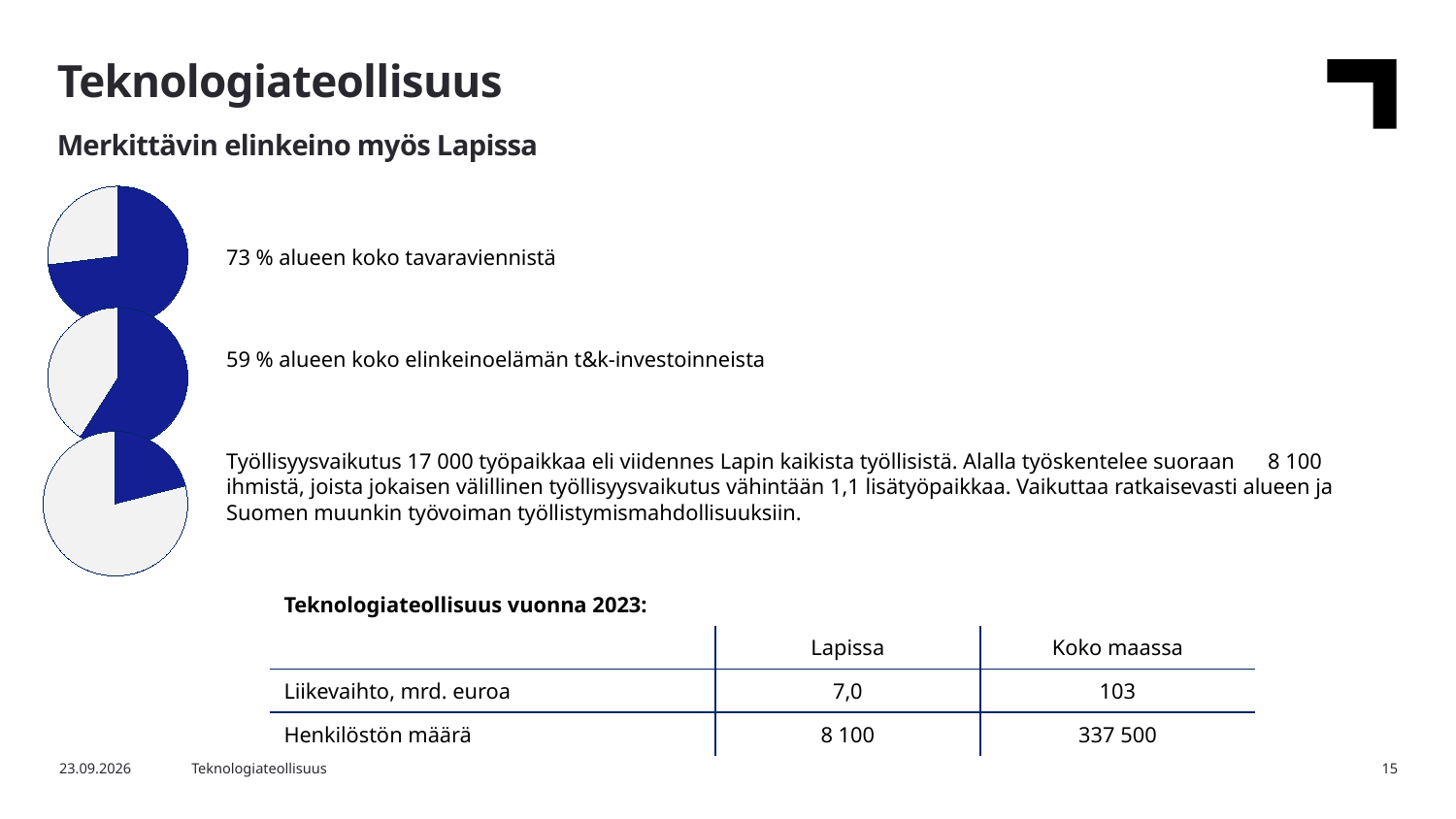
In the top pie chart, which slice is larger, the blue one or the grey one? The blue one What kind of charts are shown on the left side of the slide? Pie charts What does the blue slice of the top pie chart represent, according to the text next to it? 73 % alueen koko tavaraviennistä In the bottom pie chart, which slice is larger, the blue one or the grey one? The grey one What colour is the highlighted slice in the pie charts? Dark blue In the middle pie chart, what share does the blue slice represent? 59 % Which of the three pie charts has the largest blue slice? The top pie chart (73 %) Which of the three pie charts has the smallest blue slice? The bottom pie chart How many slices does each pie chart have? 2 Which pie chart has the larger blue slice, the top one or the middle one? The top one In the top pie chart, what share does the blue slice represent? 73 % How many pie charts are on the slide? 3